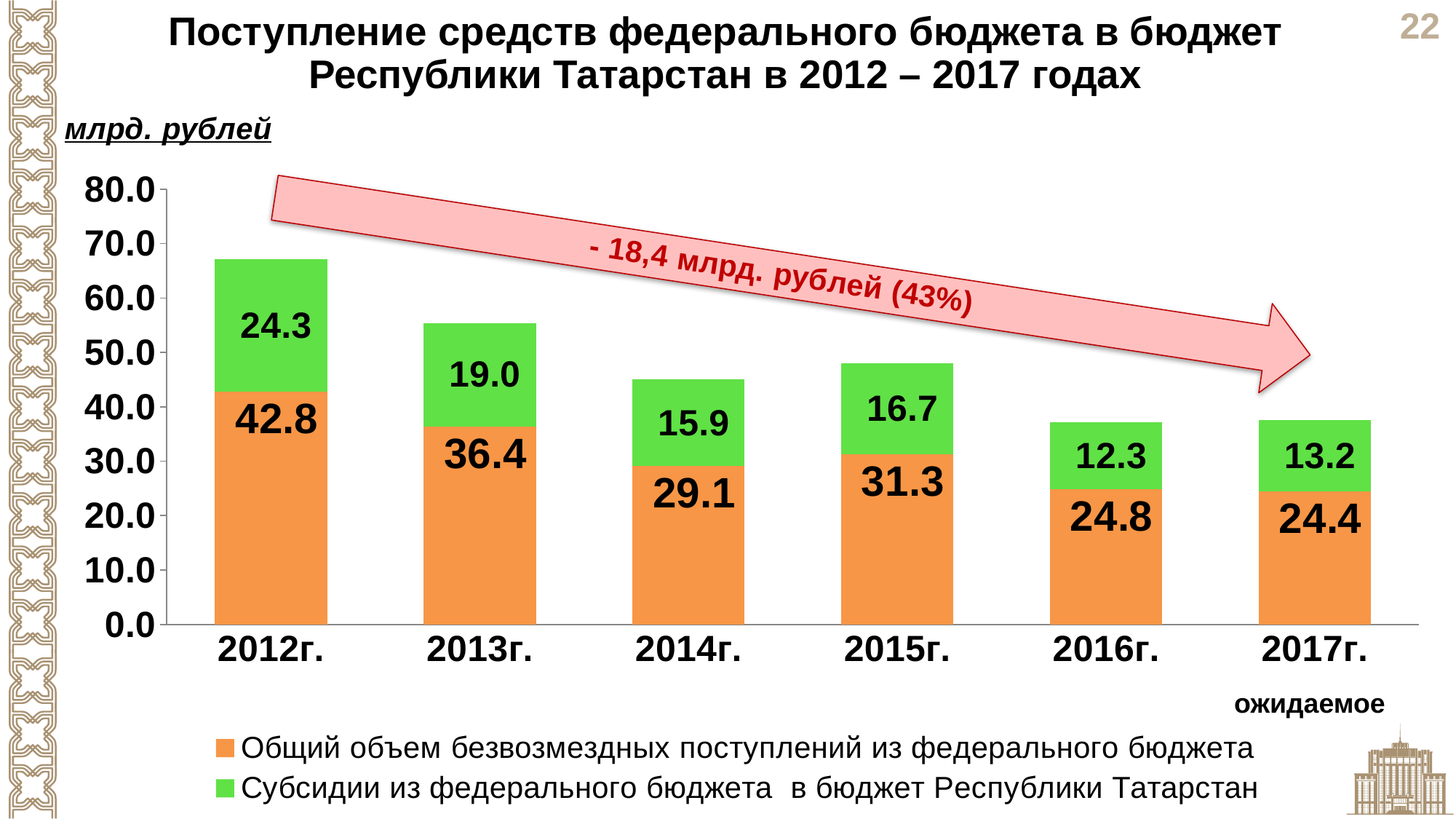
What is the total of the stacked bar for 2012г.? 67.1 What is the value of the green series (Субсидии) for 2017г.? 13.2 Which is larger: the orange series value for 2014г. or for 2015г.? 2015г. How many series does the legend list? 2 What is the total of the stacked bar for 2016г.? 37.1 How many years are shown on the x axis? 6 In which year is the orange series (Общий объем безвозмездных поступлений) highest? 2012г. What is the difference between the orange series values for 2012г. and 2013г.? 6.4 In which year is the green series (Субсидии) lowest? 2016г. What is the value of the green series (Субсидии из федерального бюджета в бюджет Республики Татарстан) for 2015г.? 16.7 What is the value of the orange series (Общий объем безвозмездных поступлений из федерального бюджета) for 2012г.? 42.8 What kind of chart is shown on the slide? Stacked bar chart